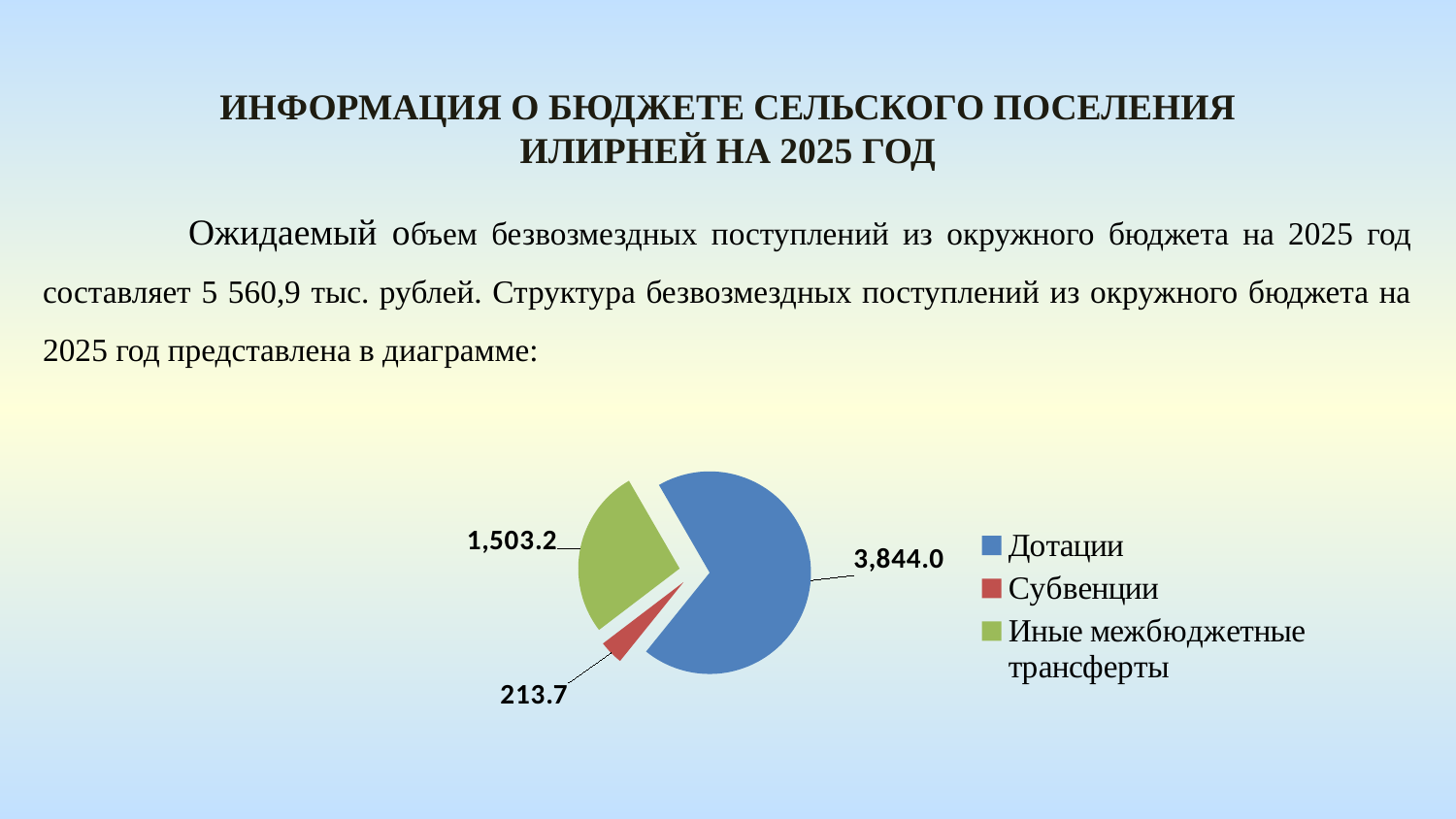
What is the value for Субвенции in the pie chart? 213.7 What is the value for Иные межбюджетные трансферты in the pie chart? 1,503.2 What type of chart is shown on the slide? Pie chart Which category has the largest slice in the pie chart? Дотации How many slices does the pie chart have? 3 What is the difference between the values for Иные межбюджетные трансферты and Субвенции? 1,289.5 What colour is the slice for Субвенции in the pie chart? Red Which category has the smallest slice in the pie chart? Субвенции What is the value for Дотации in the pie chart? 3,844.0 How many entries does the legend of the pie chart list? 3 Which is larger, the value for Субвенции or the value for Иные межбюджетные трансферты? Иные межбюджетные трансферты What is the difference between the values for Дотации and Иные межбюджетные трансферты? 2,340.8